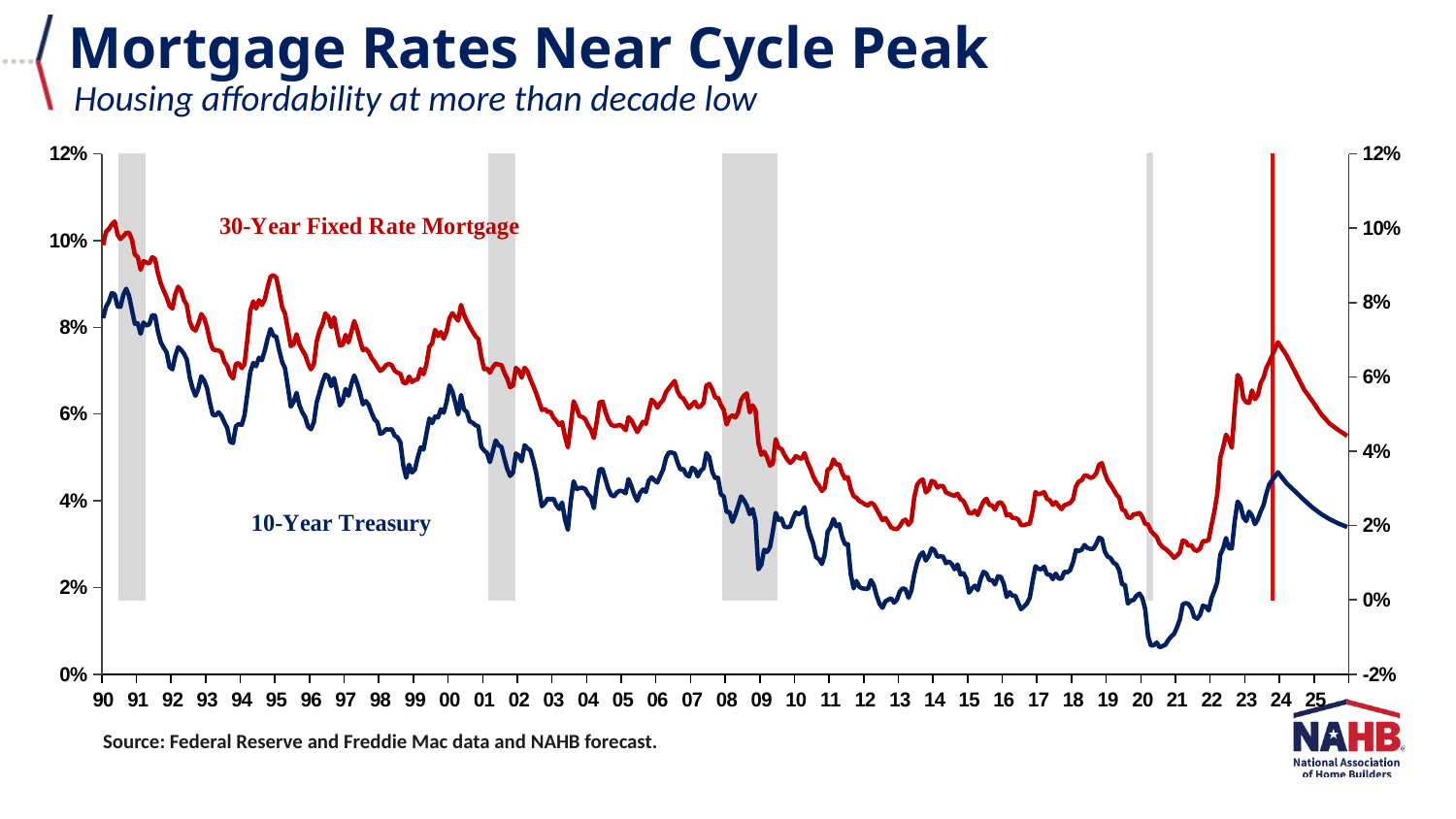
How many data series are plotted on the chart? 2 What is the highest value shown on the left vertical axis? 12% Which series is drawn in red? 30-Year Fixed Rate Mortgage What kind of chart is shown on the slide? Line chart Is the 10-Year Treasury value at its 2020 low greater or less than 2%? less Which series is higher throughout the chart, the 30-Year Fixed Rate Mortgage or the 10-Year Treasury? 30-Year Fixed Rate Mortgage Does the 30-Year Fixed Rate Mortgage generally rise or fall from 1990 to 2012? fall Is the 30-Year Fixed Rate Mortgage value at the start of 1990 greater or less than 8%? greater Does the 10-Year Treasury rise or fall from 2021 to 2023? rise Is the 30-Year Fixed Rate Mortgage value at its 2012-2013 low greater or less than 6%? less What are the names of the two series plotted on the chart? 30-Year Fixed Rate Mortgage and 10-Year Treasury